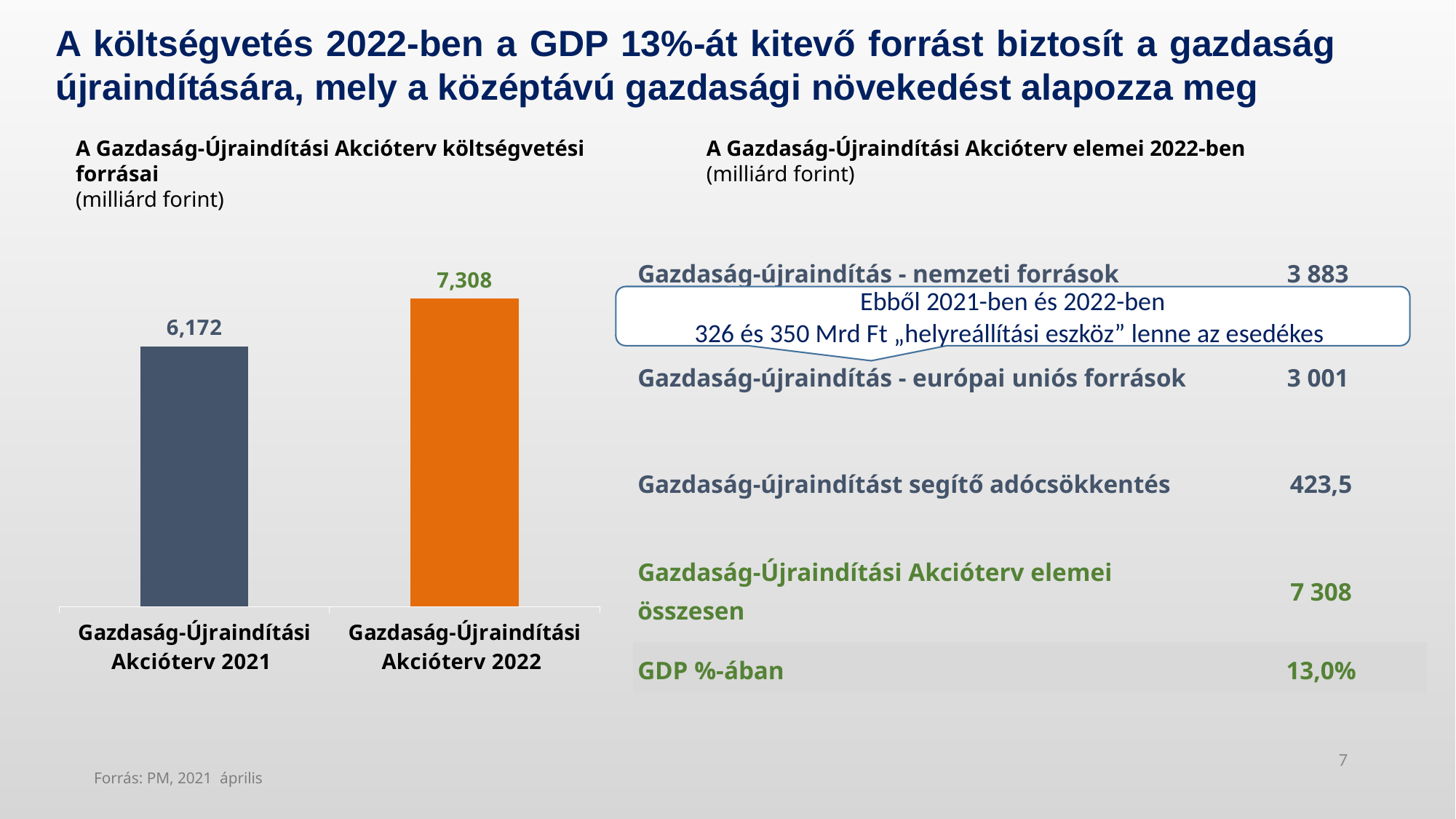
What unit is stated under the bar chart's title? milliárd forint What kind of chart is shown on the left of the slide? Bar chart Which category has the highest value in the bar chart? Gazdaság-Újraindítási Akcióterv 2022 Which is larger in the bar chart: the value for Gazdaság-Újraindítási Akcióterv 2021 or for Gazdaság-Újraindítási Akcióterv 2022? Gazdaság-Újraindítási Akcióterv 2022 What is the value for Gazdaság-Újraindítási Akcióterv 2022 in the bar chart? 7,308 What is the difference between the 2022 and 2021 values in the bar chart? 1,136 How many bars are shown in the bar chart? 2 Do the values in the bar chart rise or fall from 2021 to 2022? Rise What is the value for Gazdaság-Újraindítási Akcióterv 2021 in the bar chart? 6,172 What colour is the bar for Gazdaság-Újraindítási Akcióterv 2022? Orange Which category has the lowest value in the bar chart? Gazdaság-Újraindítási Akcióterv 2021